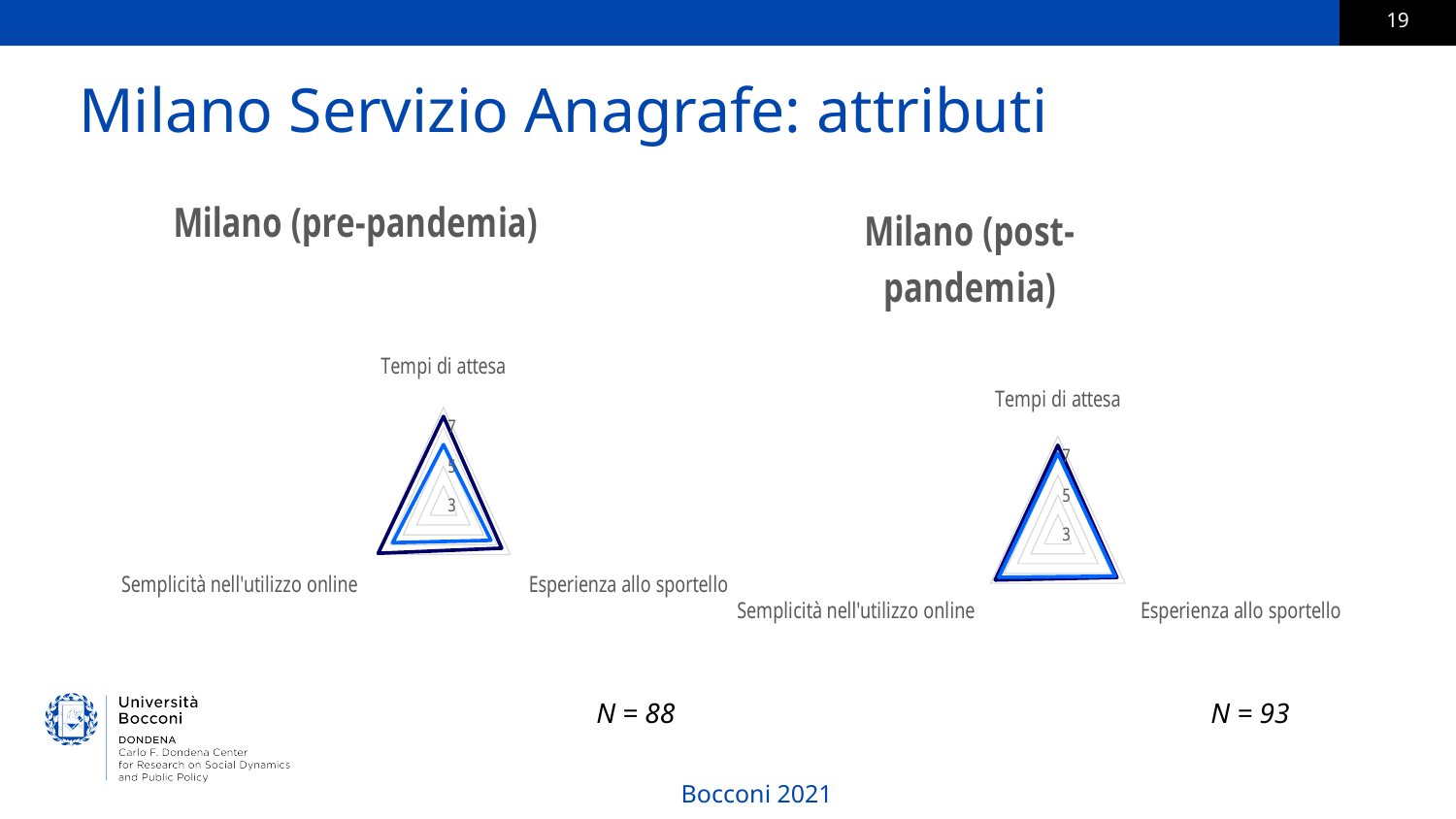
On the 'Milano (pre-pandemia)' chart, is the value for Tempi di attesa greater or less than 5? greater On the 'Milano (post-pandemia)' chart, which attribute is shown at the bottom right of the radar? Esperienza allo sportello On the 'Milano (pre-pandemia)' chart, which attribute is shown at the top of the radar? Tempi di attesa How many attributes (axes) are plotted on the 'Milano (pre-pandemia)' radar chart? 3 What sample size (N) is reported under the 'Milano (pre-pandemia)' chart? N = 88 What kind of chart is the 'Milano (post-pandemia)' chart? radar chart How many attributes (axes) are plotted on the 'Milano (post-pandemia)' radar chart? 3 On the 'Milano (pre-pandemia)' chart, is the value for Esperienza allo sportello greater or less than 3? greater What is the highest tick value shown on the axis of the 'Milano (post-pandemia)' radar chart? 7 What kind of chart is the 'Milano (pre-pandemia)' chart? radar chart On the 'Milano (post-pandemia)' chart, is the value for Semplicità nell'utilizzo online greater or less than 3? greater